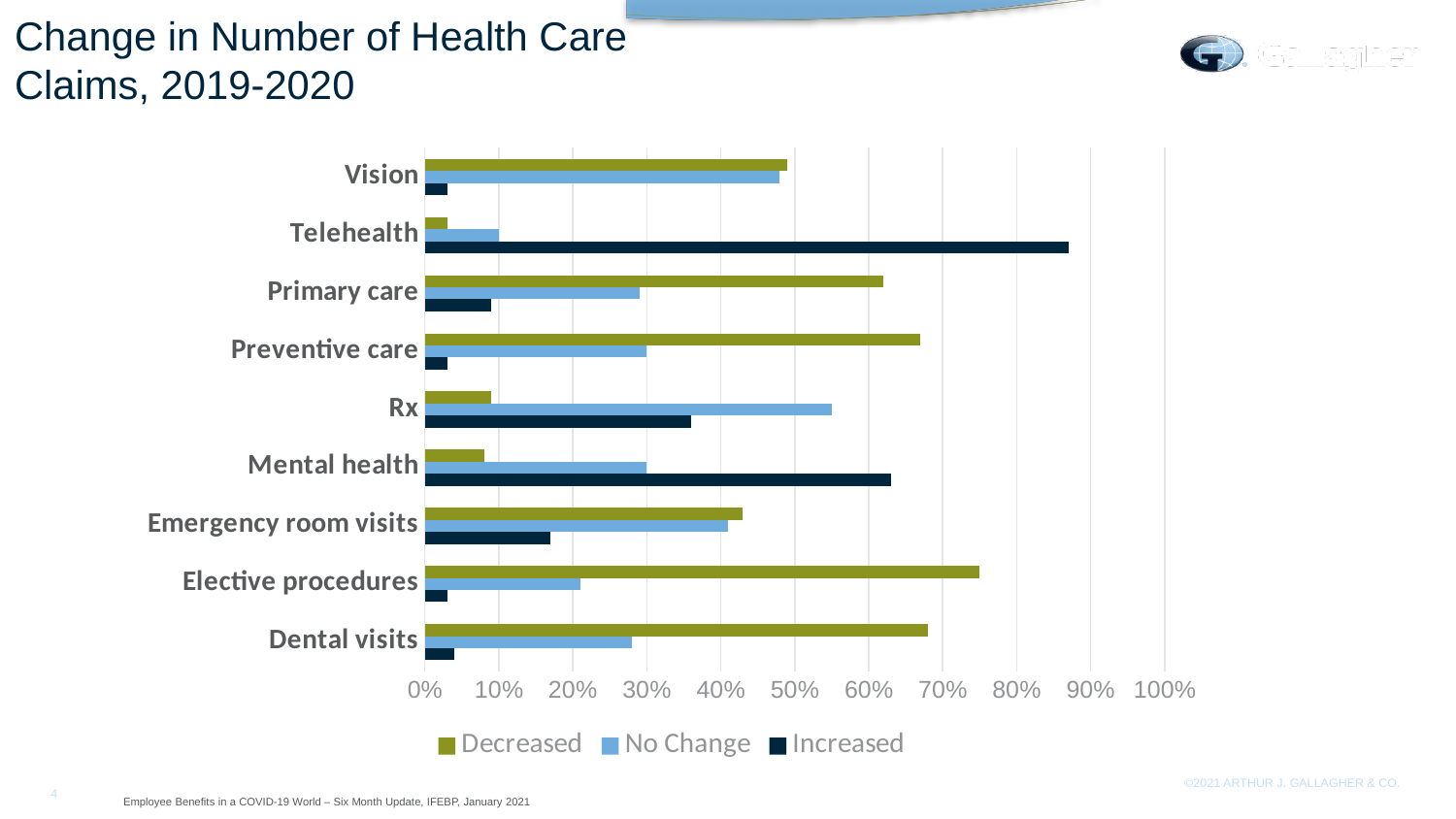
Is the Decreased value for Elective procedures greater or less than 70%? greater What kind of chart is shown on the slide? Bar chart Is the Increased value for Telehealth greater or less than 80%? greater How many categories of health care claims are shown on the chart? 9 How many series does the legend list? 3 Is the No Change value for Rx greater or less than 50%? greater Which category has the highest value for the Decreased series? Elective procedures Which category has the lowest value for the Decreased series? Telehealth Which has a larger Increased value, Mental health or Rx? Mental health What are the three series listed in the legend? Decreased, No Change, Increased Which category has the highest value for the Increased series? Telehealth